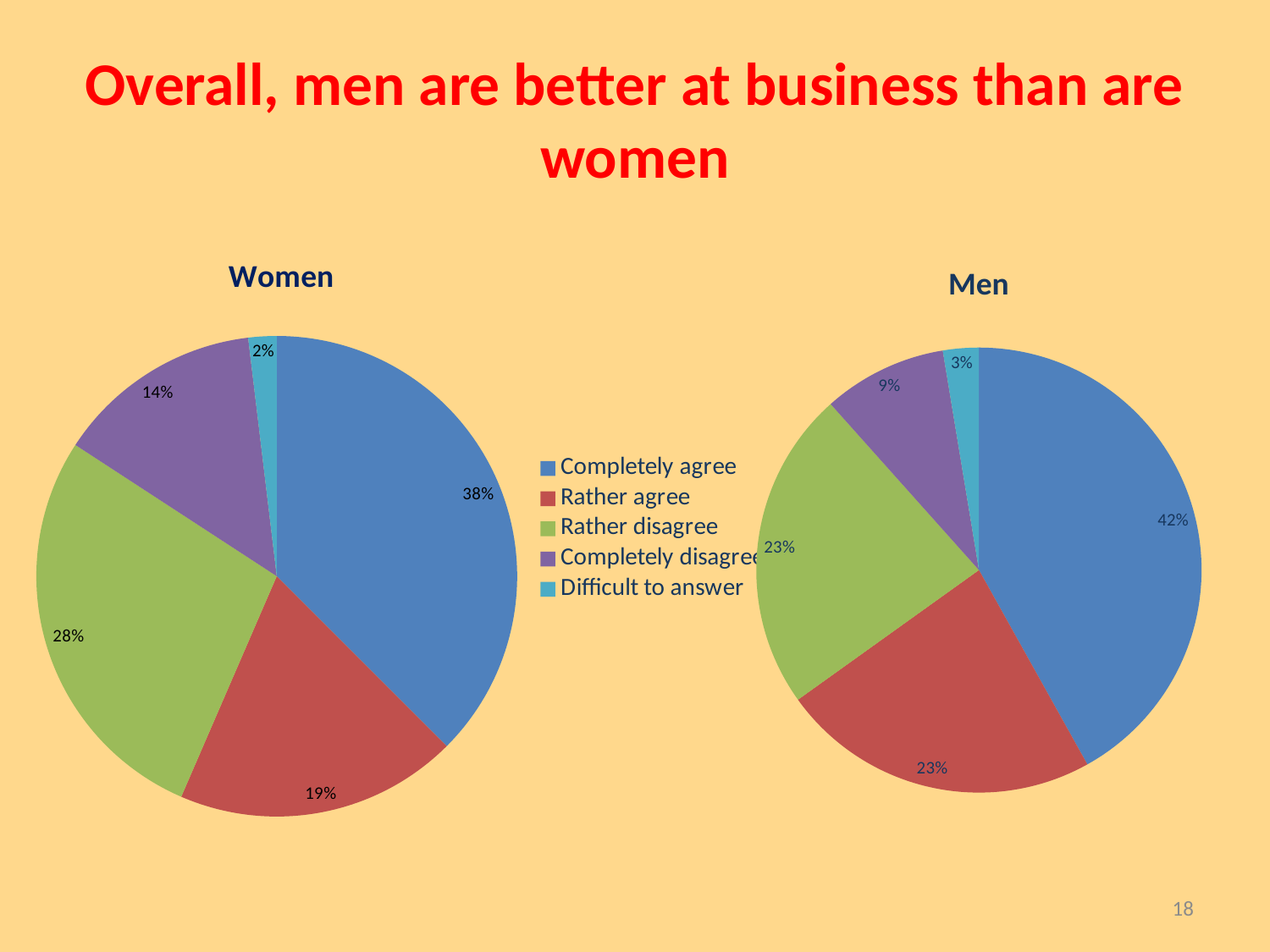
In the Men pie chart, what percentage completely disagree? 9% In the Women pie chart, what share of respondents completely agree? 38% In the Women pie chart, which is larger: Rather agree or Rather disagree? Rather disagree How many slices does the Men pie chart have? 5 In the Men pie chart, what share of respondents completely agree? 42% How many entries does the legend list? 5 In the Women pie chart, which response has the smallest share? Difficult to answer In the Men pie chart, which response has the largest share? Completely agree What is the difference between the Completely agree share in the Men chart and in the Women chart? 4% In the Women pie chart, what is the difference between Rather disagree and Completely disagree? 14% What type of chart is used for the Women and Men data? Pie chart In the Women pie chart, what percentage rather disagree? 28%